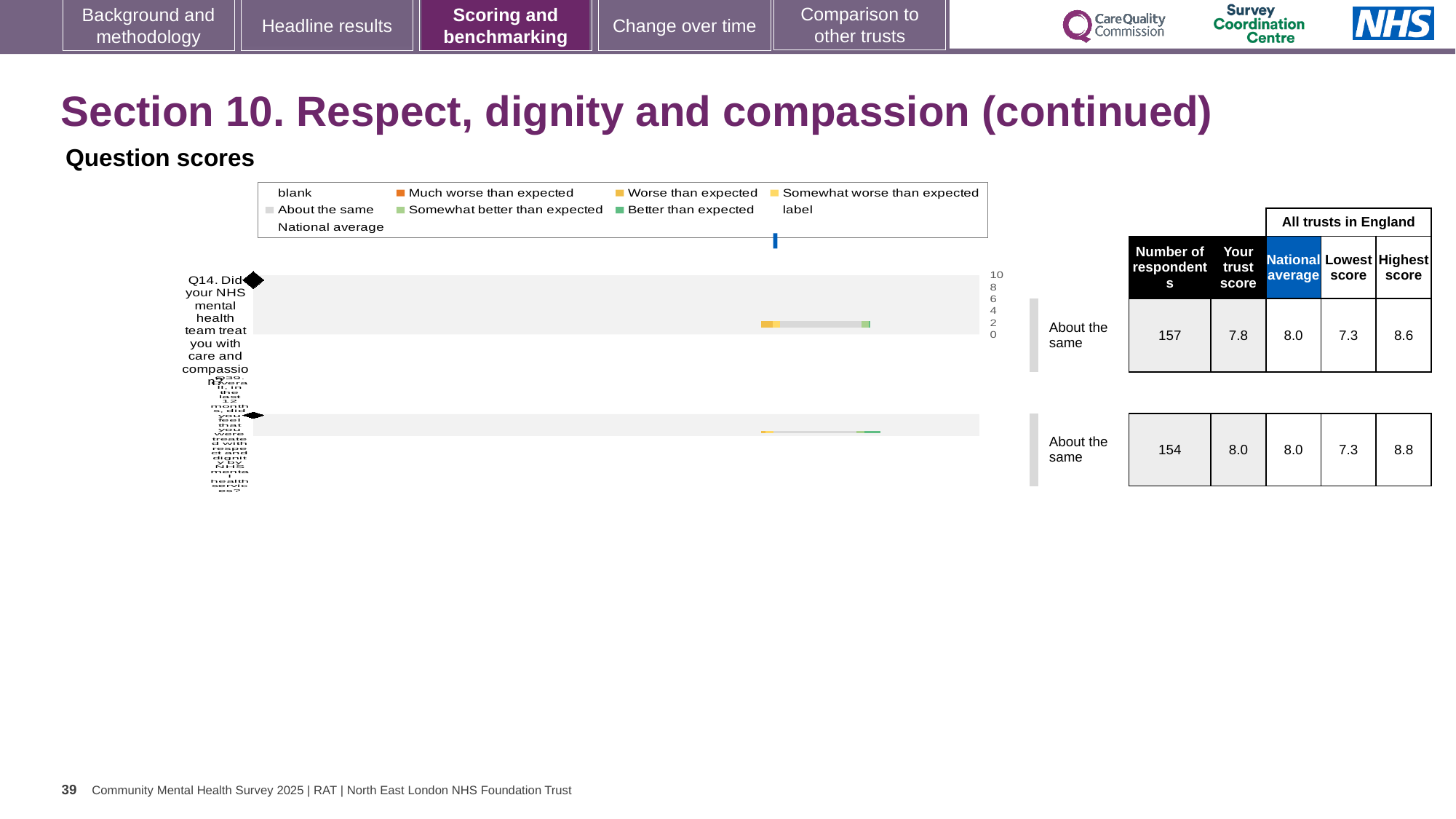
What benchmark category is shown for Q14 in the question scores chart? About the same What is the trust's score for Q14 (care and compassion)? 7.8 By how much is the trust's score for Q14 below the national average? 0.2 What is the national average score for Q39 (respect and dignity)? 8.0 What is the number of respondents for Q14 (care and compassion)? 157 How many questions are plotted in the question scores chart? 2 What kind of chart is used to show the question scores on this slide? bar chart What is the lowest score among all trusts in England for Q14? 7.3 What is the difference between the highest and lowest scores for Q14? 1.3 Which question has the higher trust score, Q14 or Q39? Q39 What is the highest score among all trusts in England for Q39? 8.8